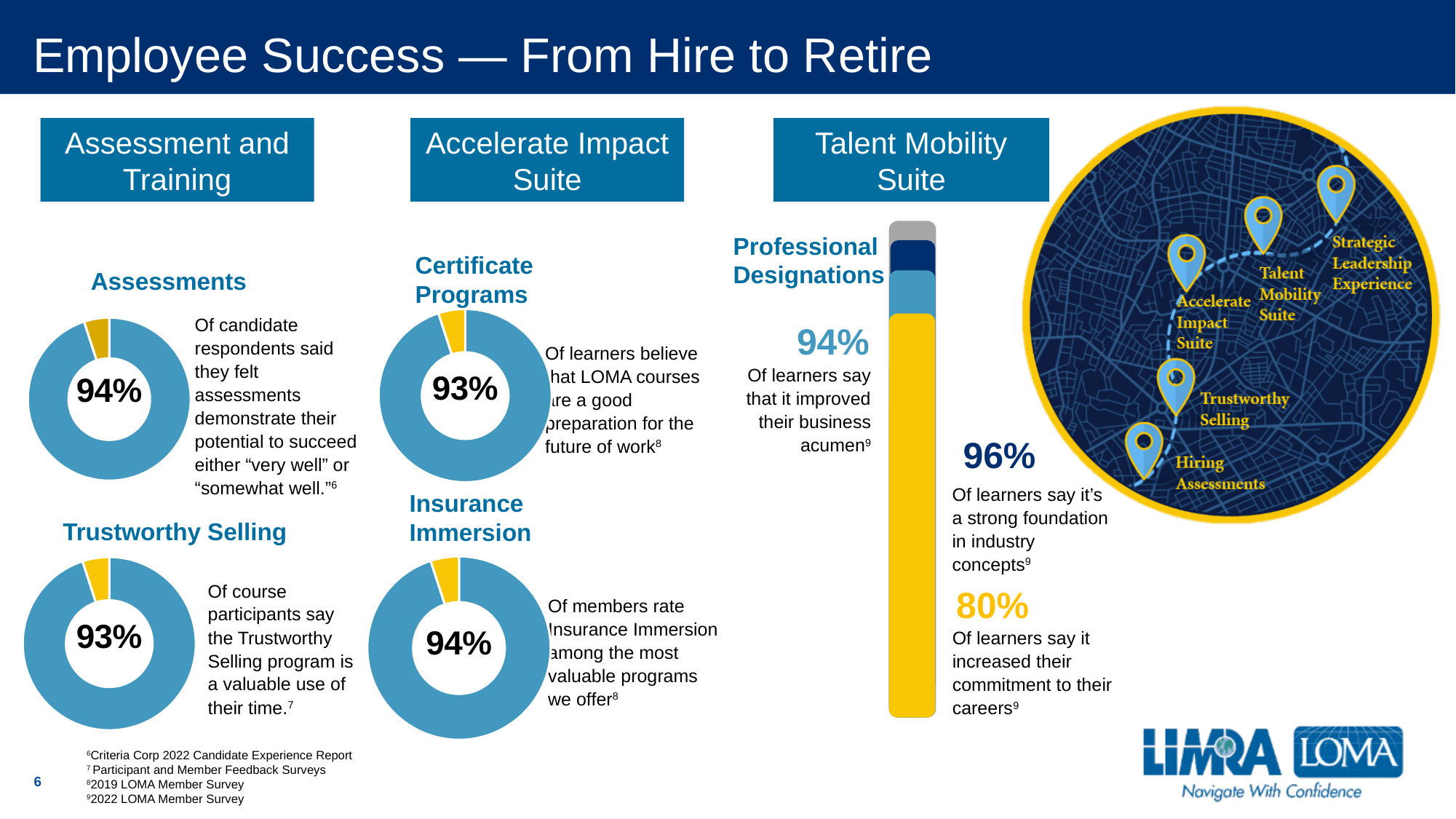
Under Professional Designations, what percentage of learners say it increased their commitment to their careers? 80% What percentage is shown in the centre of the Trustworthy Selling donut chart? 93% What is the difference between the Insurance Immersion donut value and the Certificate Programs donut value? 1% What percentage is shown in the centre of the Insurance Immersion donut chart? 94% Which is larger, the Assessments donut value or the Trustworthy Selling donut value? Assessments In the Certificate Programs donut chart, what colour is the small remaining segment? Yellow What percentage is shown in the centre of the Certificate Programs donut chart? 93% Is the value in the Insurance Immersion donut chart greater or less than 90%? greater How many donut charts are shown on the slide? 4 What kind of chart is used to show the Assessments figure? Donut (pie) chart In the Trustworthy Selling donut chart, what colour is the large 93% segment? Blue What percentage is shown in the centre of the Assessments donut chart? 94%